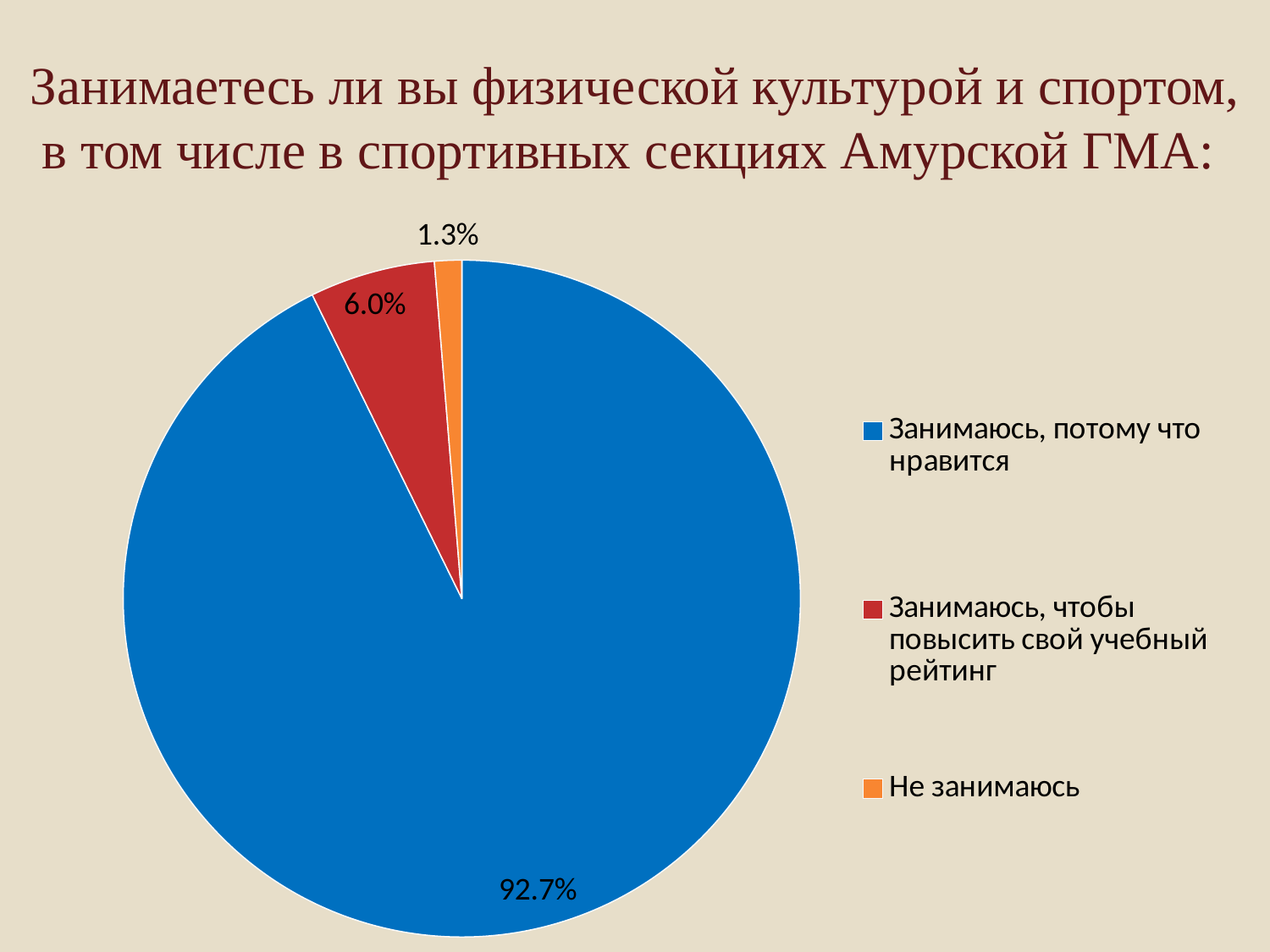
What percentage is shown for "Занимаюсь, потому что нравится"? 92.7% What percentage is shown for "Занимаюсь, чтобы повысить свой учебный рейтинг"? 6.0% What is the difference between the shares for "Занимаюсь, чтобы повысить свой учебный рейтинг" and "Не занимаюсь"? 4.7% What kind of chart is shown on the slide? Pie chart What percentage is shown for "Не занимаюсь"? 1.3% How many categories does the pie chart have? 3 Which category has the smallest slice of the pie? Не занимаюсь Which is larger: the share for "Занимаюсь, чтобы повысить свой учебный рейтинг" or the share for "Не занимаюсь"? Занимаюсь, чтобы повысить свой учебный рейтинг What colour is the slice for "Не занимаюсь"? Orange Which category has the largest slice of the pie? Занимаюсь, потому что нравится What is the difference between the shares for "Занимаюсь, потому что нравится" and "Занимаюсь, чтобы повысить свой учебный рейтинг"? 86.7% How many entries does the legend list? 3